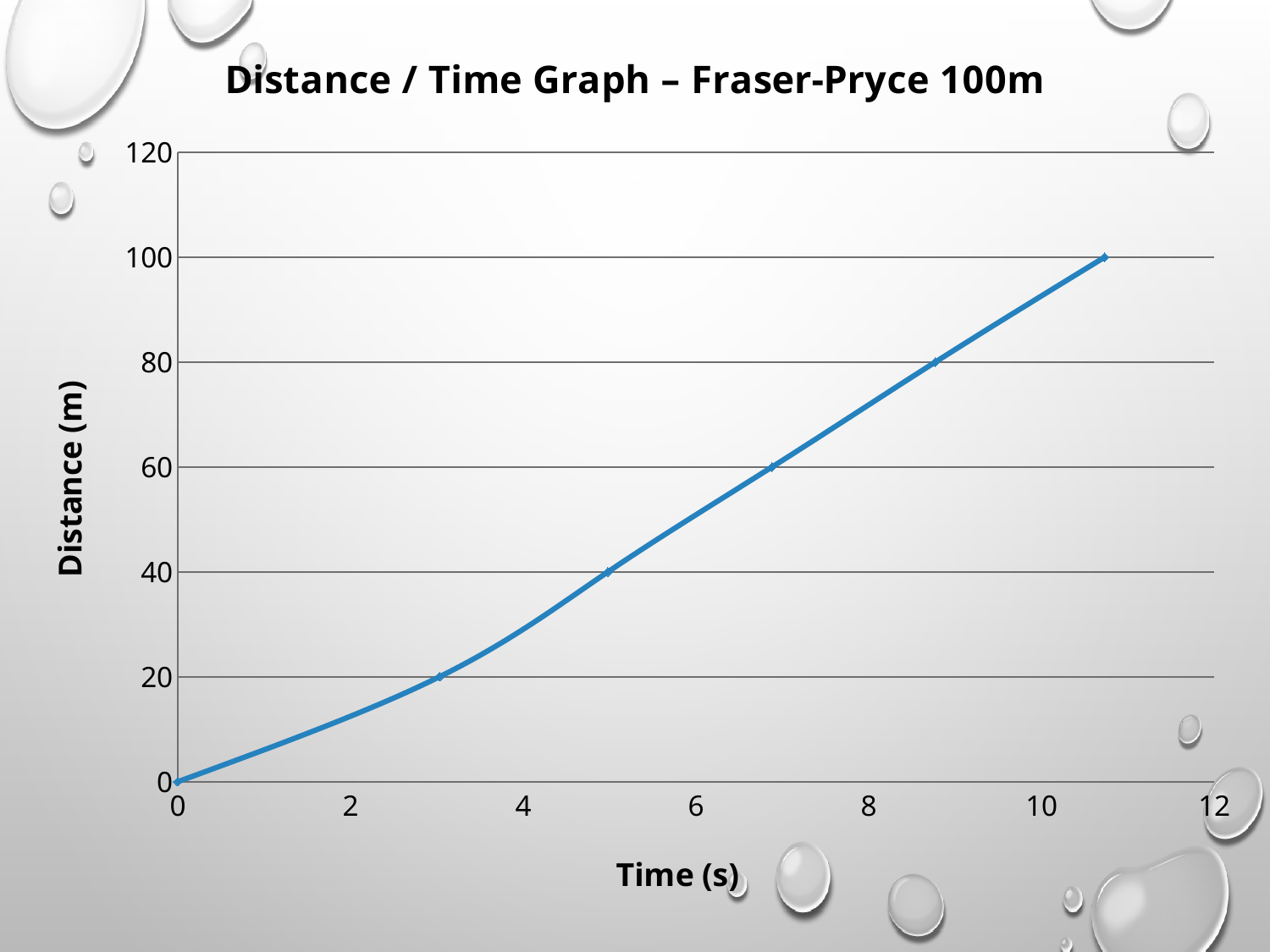
What is the lowest distance value on the line? 0 Is the distance at a time of 6 s greater or less than 40? greater Is the distance at a time of 10 s greater or less than 80? greater What is the highest distance value reached by the line? 100 Is the distance at a time of 8 s greater or less than 60? greater What is the title of the chart? Distance / Time Graph – Fraser-Pryce 100m How many data points are plotted on the line? 6 Does the distance rise or fall as time increases along the x axis? rise What is the label of the vertical axis? Distance (m) What kind of chart is shown on the slide? line chart